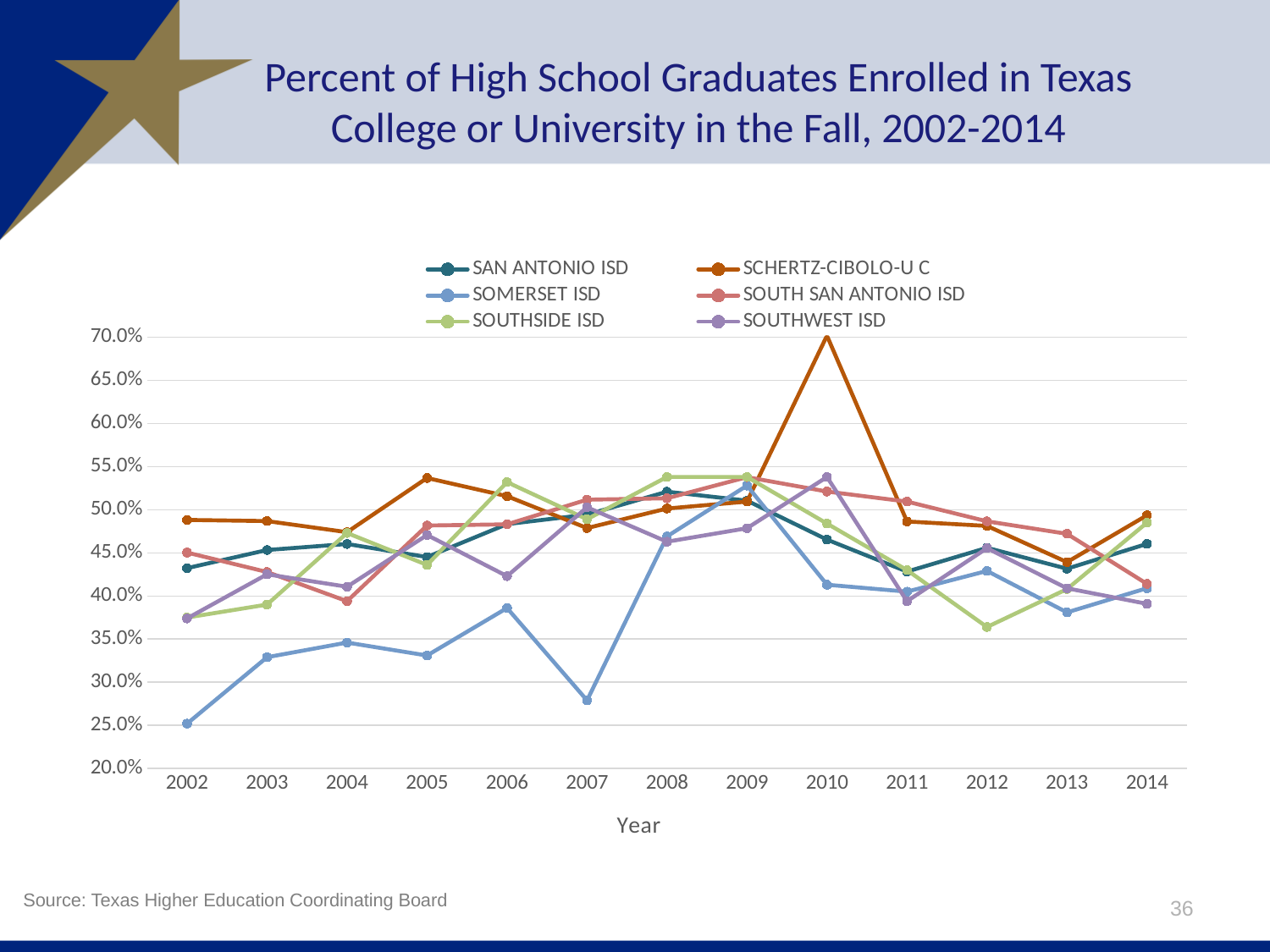
Is the value for SOMERSET ISD in 2002 greater or less than 30.0%? less Which series has the highest value in 2010? SCHERTZ-CIBOLO-U C What kind of chart is shown on the slide? line chart What is the title of the x axis? Year Which series has the lowest value in 2012? SOUTHSIDE ISD Is the value for SCHERTZ-CIBOLO-U C in 2005 greater or less than 50.0%? greater How many years are shown along the x axis? 13 Which series has the lowest value in 2002? SOMERSET ISD In 2002, which is larger: the value for SCHERTZ-CIBOLO-U C or the value for SOMERSET ISD? SCHERTZ-CIBOLO-U C Is the value for SCHERTZ-CIBOLO-U C in 2010 greater or less than 65.0%? greater How many series does the legend list? 6